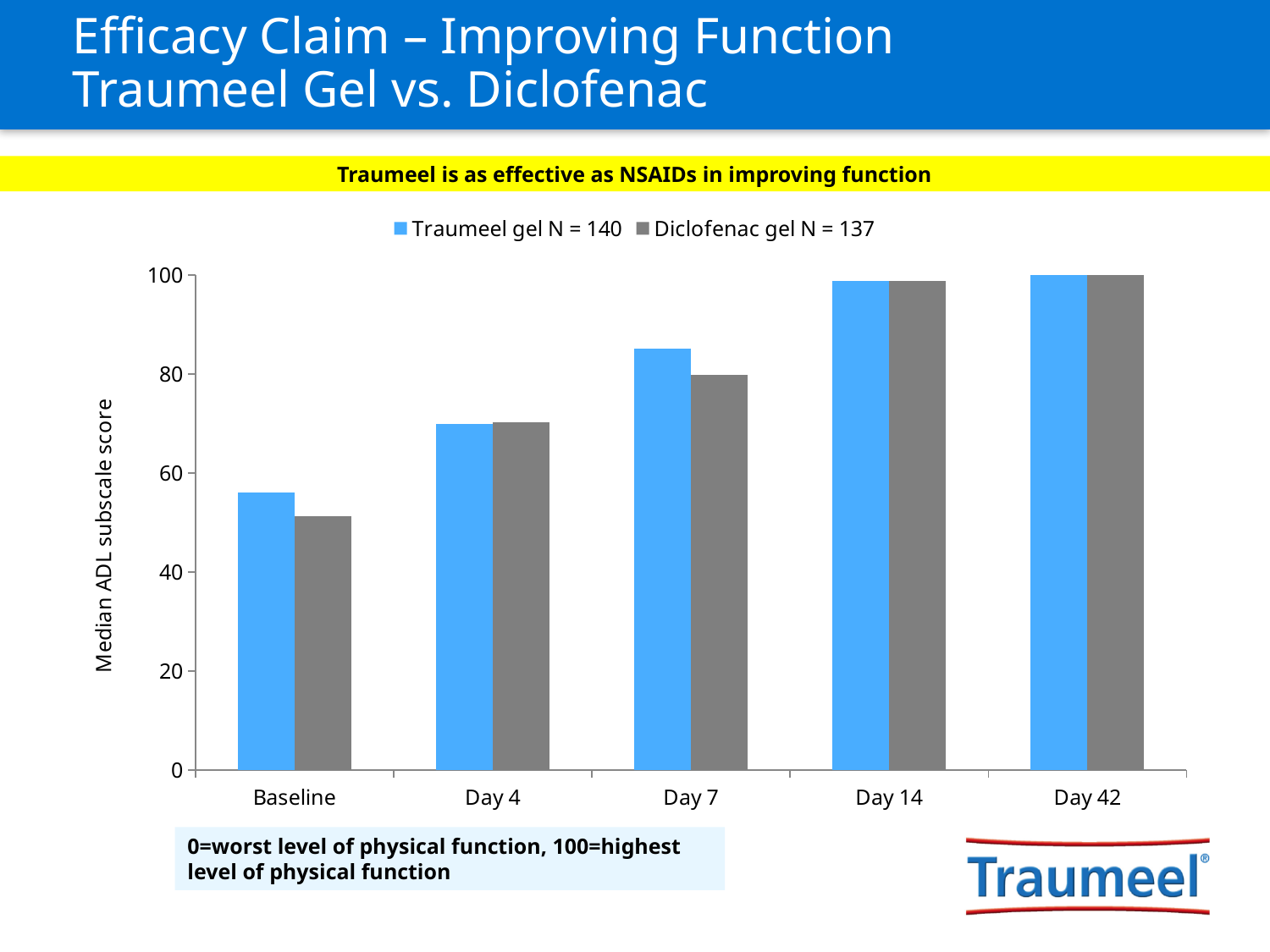
At Baseline, which is larger: the Traumeel gel value or the Diclofenac gel value? Traumeel gel Which category has the lowest Median ADL subscale score for Traumeel gel? Baseline Is the Day 7 value for Traumeel gel greater or less than 80? greater How many time-point categories are shown on the x axis? 5 What is the label on the y axis? Median ADL subscale score Which category has the lowest Median ADL subscale score for Diclofenac gel? Baseline Is the Baseline value for Diclofenac gel greater or less than 60? less How many series does the legend list? 2 At Day 7, which is larger: the Traumeel gel value or the Diclofenac gel value? Traumeel gel What kind of chart is shown on the slide? bar chart What sample size (N) does the legend give for Diclofenac gel? 137 Do the Traumeel gel values rise or fall from Baseline to Day 42? rise